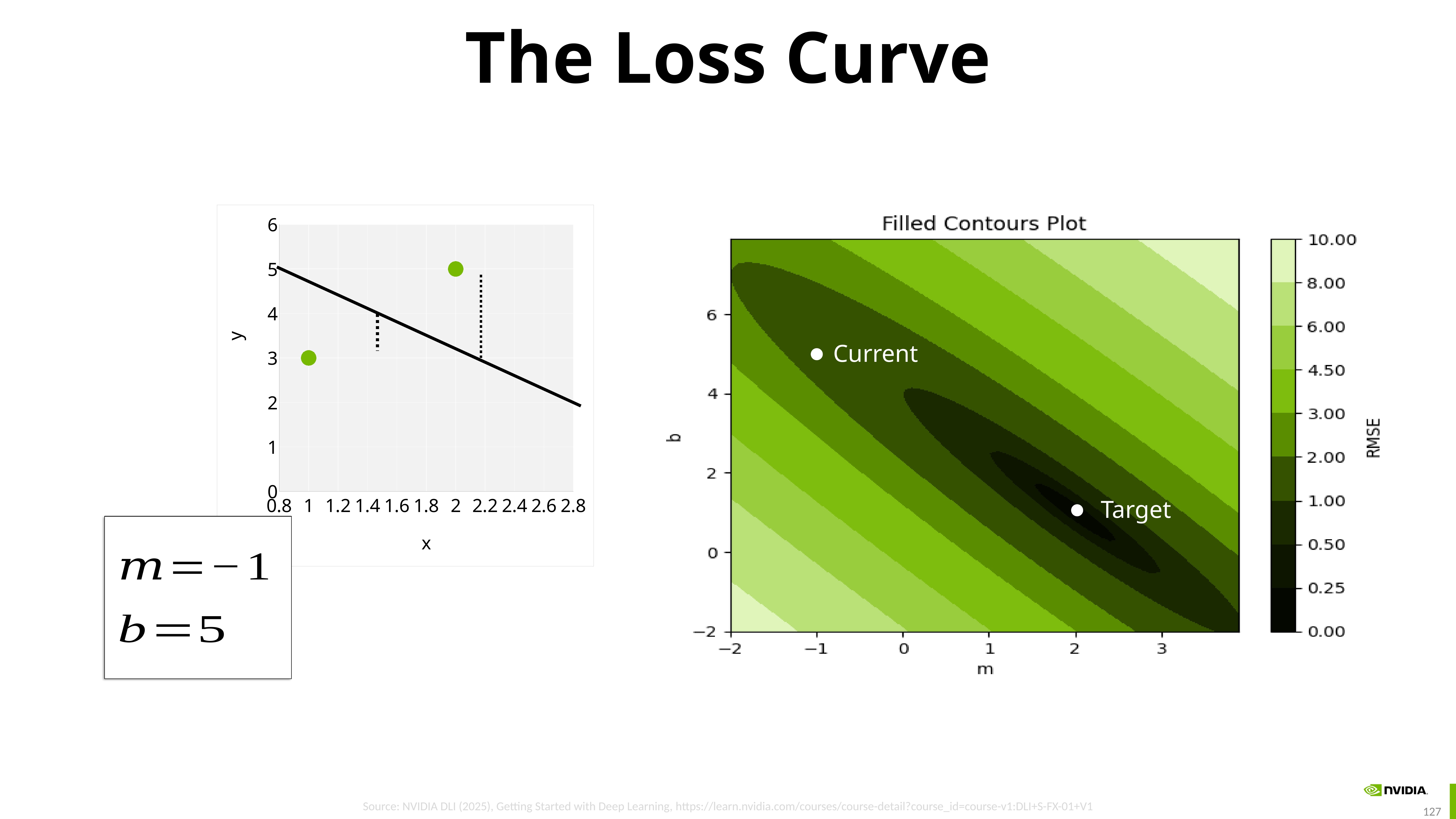
In the right chart, what is the m value of the point labelled Current? -1 In the right chart, what is the highest value shown on the colour bar? 10.00 In the left chart, what is the y value of the data point at x = 1? 3 In the left chart, does the black line rise or fall as x increases? fall In the left chart, what is the y value of the data point at x = 2? 5 In the left chart, what is the difference in y between the data point at x = 2 and the data point at x = 1? 2 In the left chart, how many green data points are plotted? 2 In the right chart, what quantity does the colour bar represent? RMSE What is the title of the right chart? Filled Contours Plot What kind of chart is the left chart with axes x and y? scatter plot In the right chart, which labelled point lies in the darker (lower RMSE) region, Current or Target? Target In the left chart, which data point has the higher y value, the one at x = 1 or the one at x = 2? x = 2